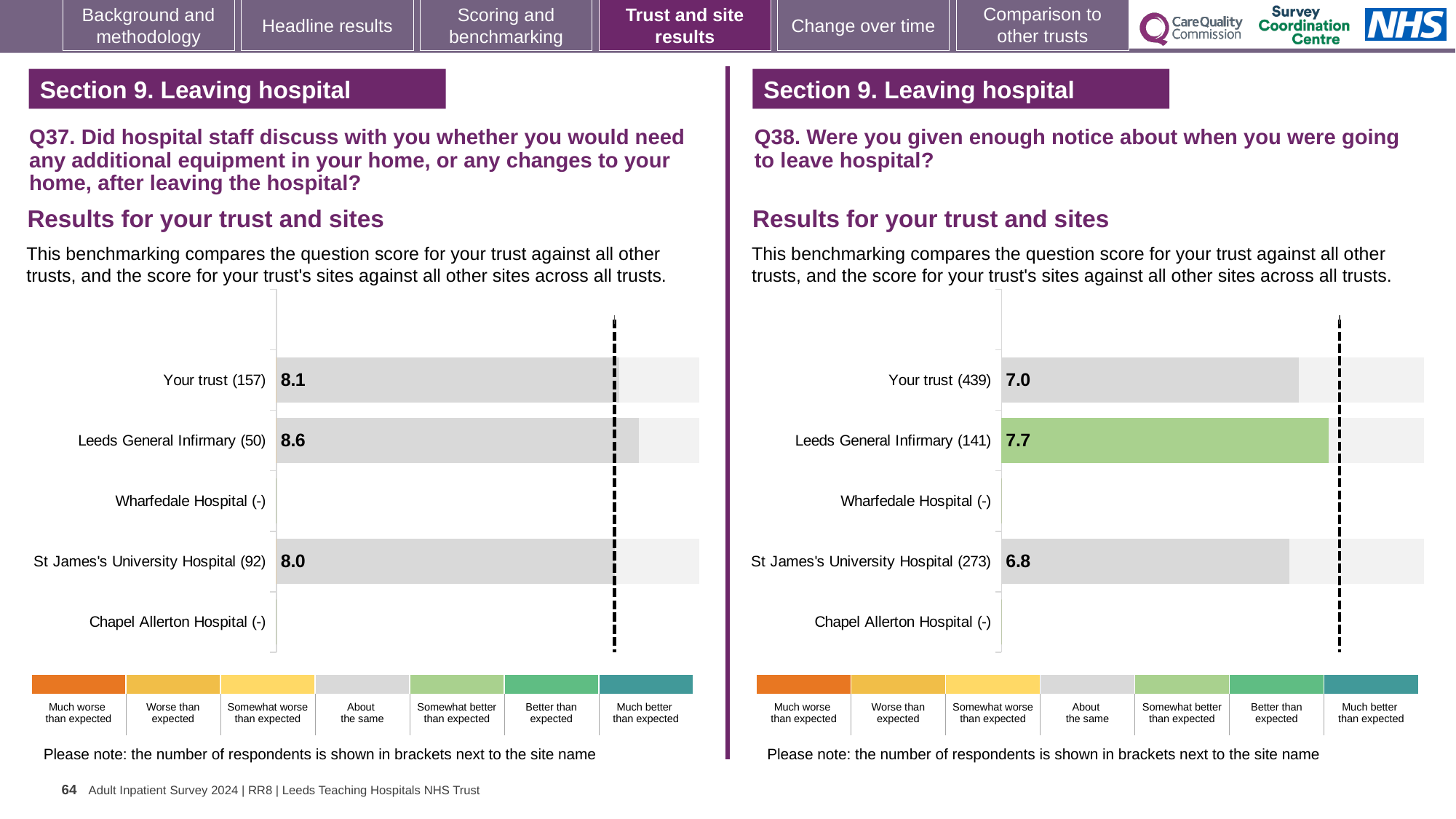
In the Q37 chart on the left, which has the higher score, Your trust or Leeds General Infirmary? Leeds General Infirmary In the Q37 chart on the left, what is the score for Your trust? 8.1 In the Q37 chart on the left, what is the score for St James's University Hospital? 8.0 In the Q38 chart on the right, which site or trust has the lowest score? St James's University Hospital In the Q38 chart on the right, which site or trust has the highest score? Leeds General Infirmary How many sites or trusts are listed on the Q38 chart on the right? 5 In the Q38 chart on the right, what is the score for Your trust? 7.0 In the Q38 chart on the right, what is the difference between the scores for Leeds General Infirmary and Your trust? 0.7 In the Q37 chart on the left, what is the score for Leeds General Infirmary? 8.6 In the Q38 chart on the right, how many respondents are shown in brackets for Your trust? 439 In the Q37 chart on the left, what is the difference between the scores for Leeds General Infirmary and St James's University Hospital? 0.6 In the Q38 chart on the right, what is the score for St James's University Hospital? 6.8